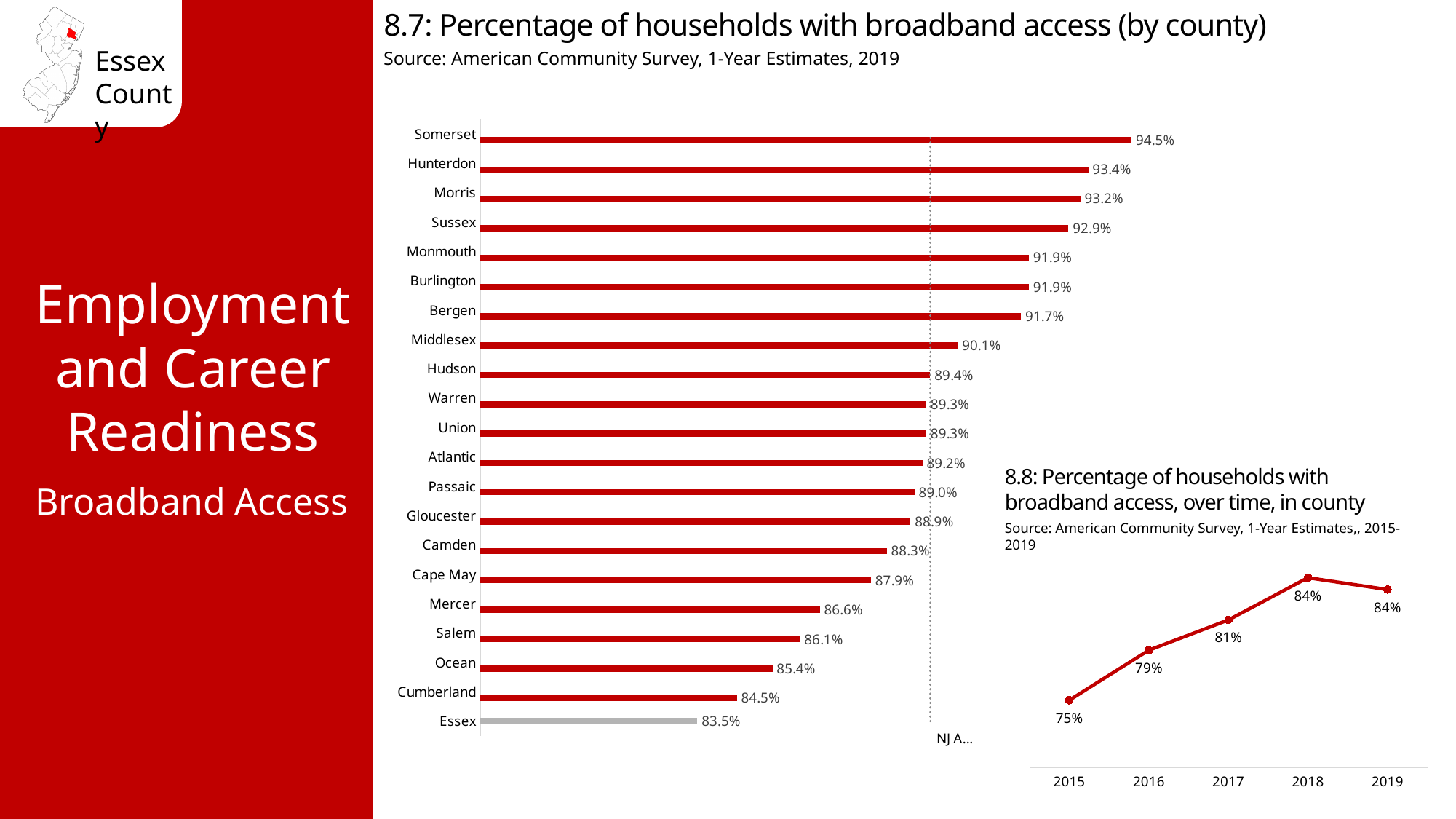
In chart 8.8, what was the percentage of households with broadband access in 2015? 75% In chart 8.7, which county has a higher value, Bergen or Middlesex? Bergen In chart 8.8, what is the difference between the 2019 value and the 2015 value? 9% In chart 8.7, what is the difference between the values for Somerset and Essex? 11.0% In chart 8.8, what was the value in 2018? 84% In chart 8.7, what percentage of households in Somerset have broadband access? 94.5% In chart 8.7, what is the value for Essex? 83.5% What kind of chart is chart 8.7? Bar chart In chart 8.7, which county has the lowest percentage of households with broadband access? Essex In chart 8.7, how many counties are shown? 21 In chart 8.8, how many years are plotted? 5 In chart 8.7, which county has the highest percentage of households with broadband access? Somerset